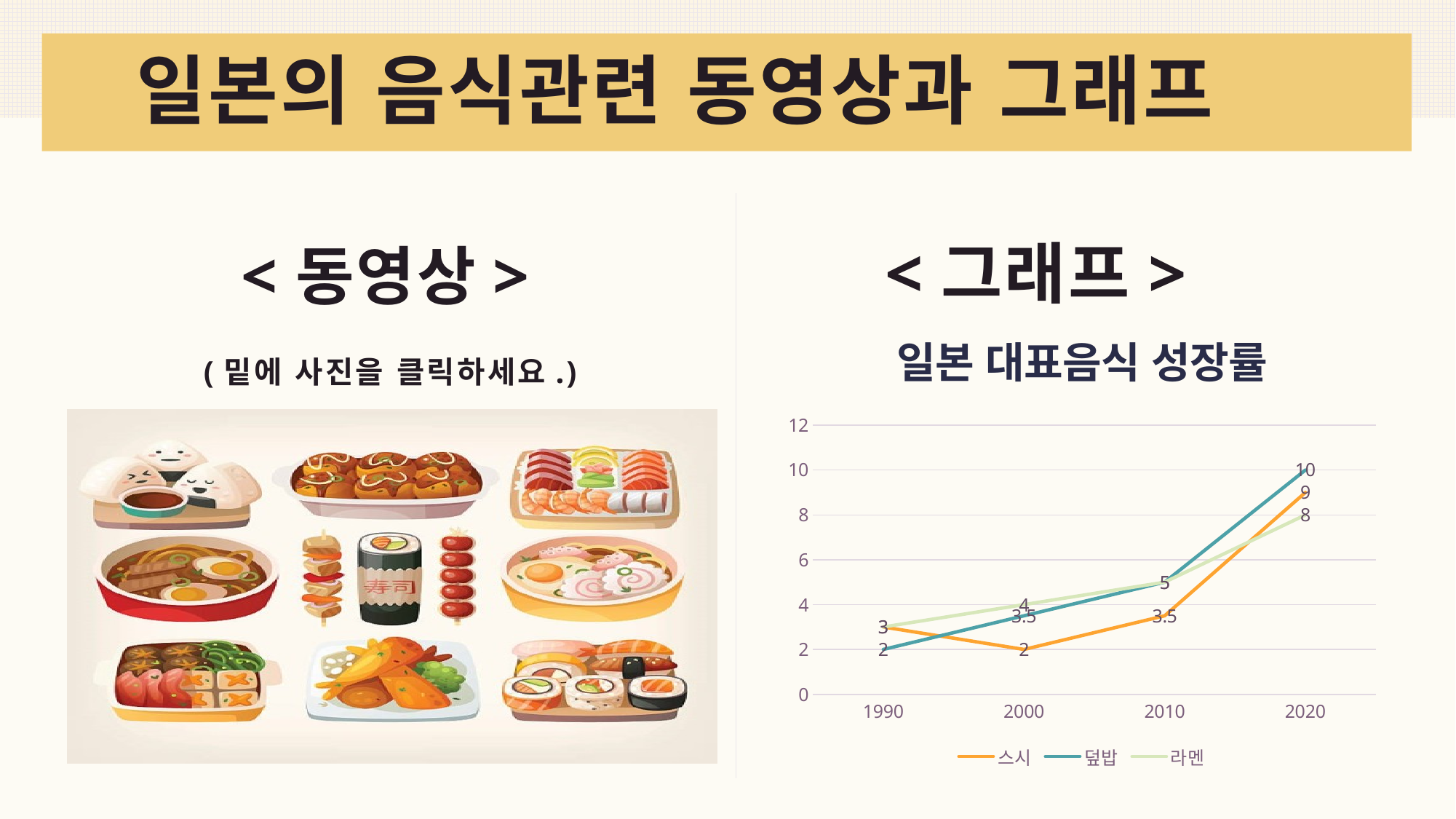
How many years are shown on the x axis of the '일본 대표음식 성장률' chart? 4 What is the value for 덮밥 in 2020? 10 Does the 덮밥 line rise or fall from 1990 to 2020? rise What is the value for 스시 in 2000? 2 What is the difference between the 덮밥 and 스시 values in 2020? 1 What kind of chart is shown under '일본 대표음식 성장률'? line chart How many series does the legend of the '일본 대표음식 성장률' chart list? 3 What is the value for 스시 in 2020? 9 Which series has the highest value in 2020? 덮밥 What is the value for 덮밥 in 1990? 2 What is the value for 라멘 in 2020? 8 Which series has the lowest value in 2020? 라멘